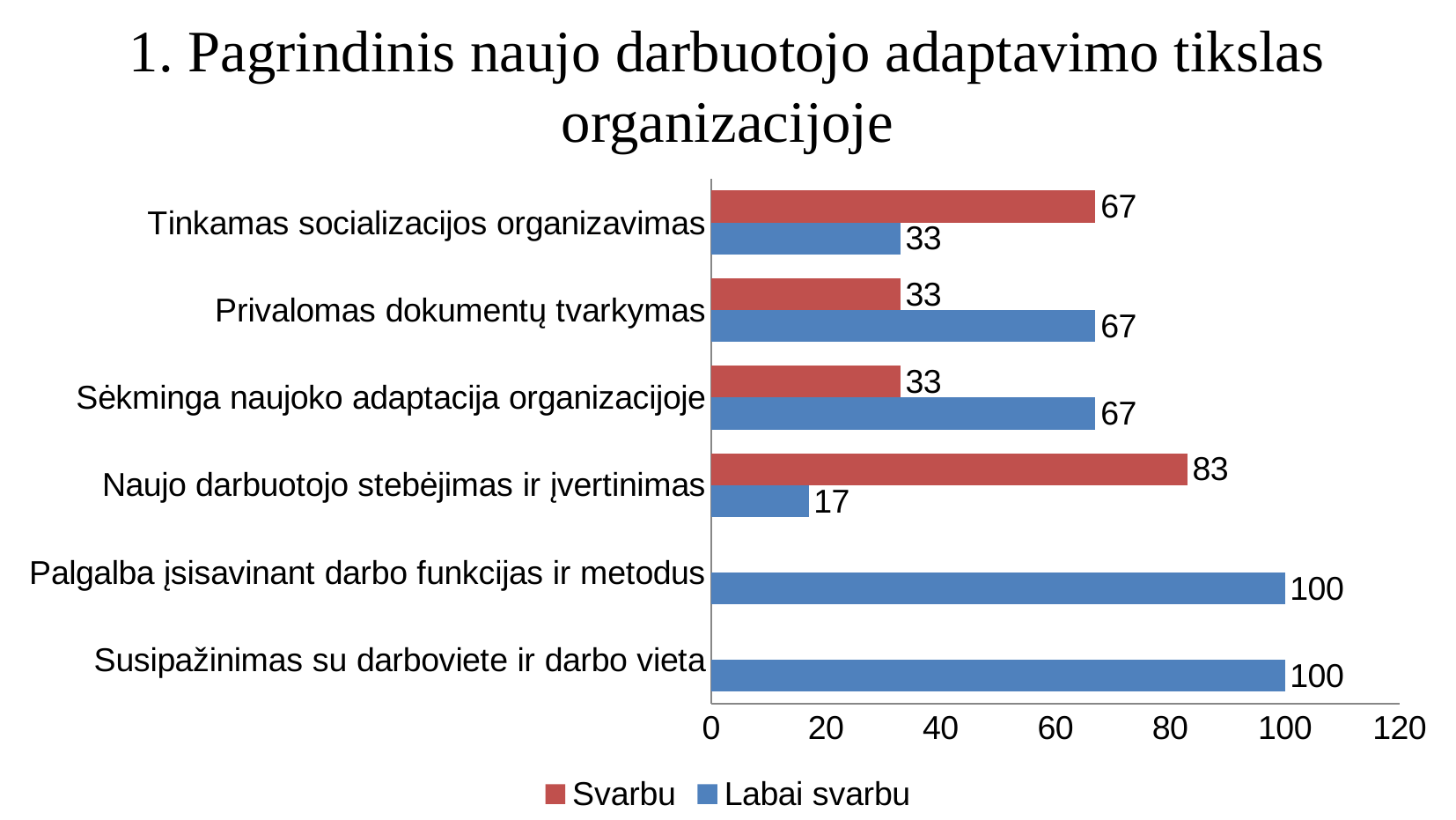
What is the difference between the 'Svarbu' and 'Labai svarbu' values for 'Naujo darbuotojo stebėjimas ir įvertinimas'? 66 What is the 'Svarbu' value for 'Privalomas dokumentų tvarkymas'? 33 What is the 'Labai svarbu' value for 'Palgalba įsisavinant darbo funkcijas ir metodus'? 100 What is the 'Svarbu' value for 'Naujo darbuotojo stebėjimas ir įvertinimas'? 83 Which category has the highest 'Svarbu' value? Naujo darbuotojo stebėjimas ir įvertinimas Which category has the lowest 'Labai svarbu' value? Naujo darbuotojo stebėjimas ir įvertinimas How many categories are shown on the chart? 6 How many series does the legend list? 2 What colour represents the 'Svarbu' series? Red What kind of chart is shown on the slide? Bar chart For 'Sėkminga naujoko adaptacija organizacijoje', which is larger: 'Svarbu' or 'Labai svarbu'? Labai svarbu What is the 'Labai svarbu' value for 'Tinkamas socializacijos organizavimas'? 33